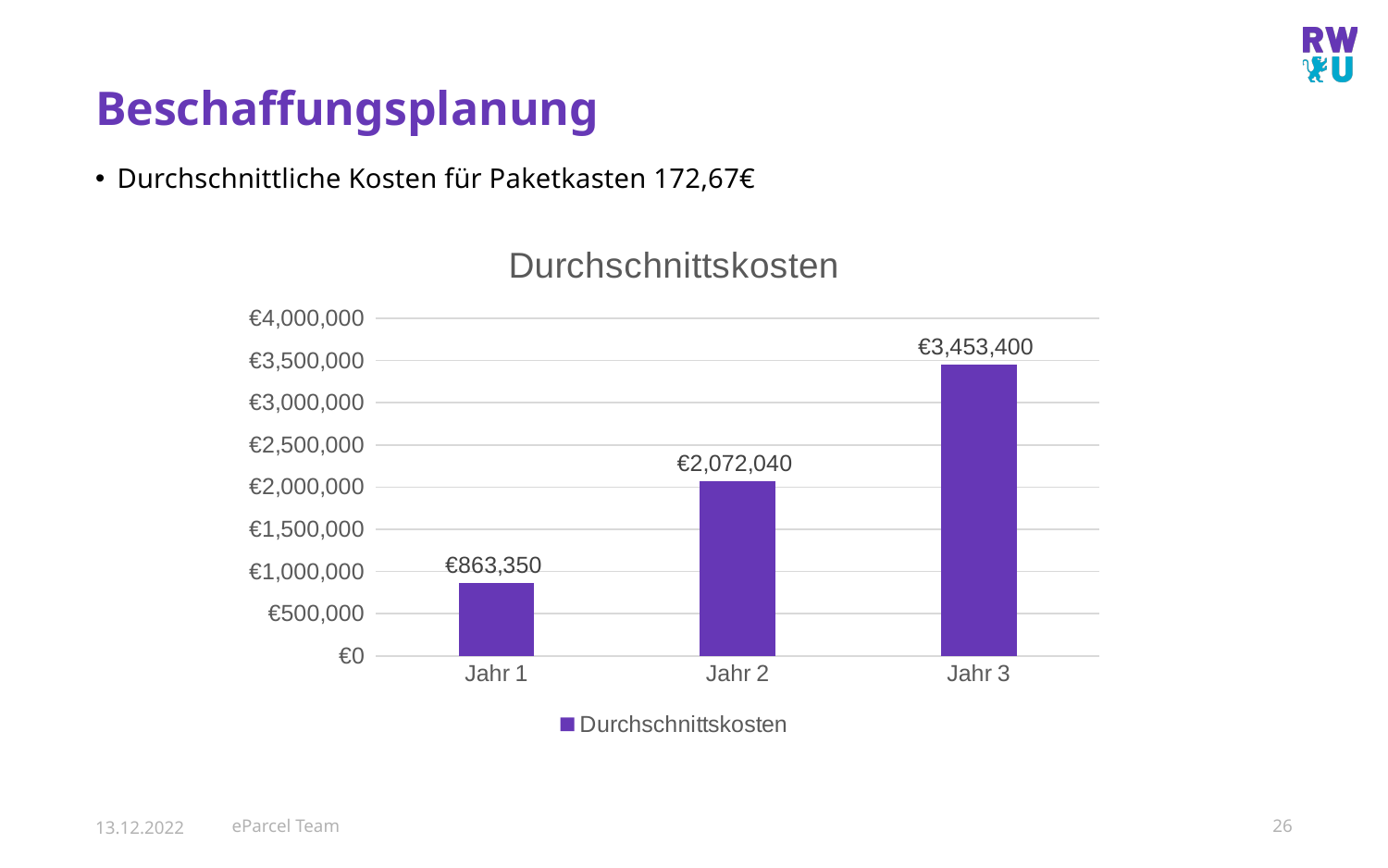
What is the difference between the values for Jahr 2 and Jahr 1? €1,208,690 What is the value for Jahr 2 in the Durchschnittskosten chart? €2,072,040 What is the value for Jahr 3 in the Durchschnittskosten chart? €3,453,400 How many categories are shown on the x axis of the chart? 3 Which year has the highest Durchschnittskosten? Jahr 3 Which is larger, the value for Jahr 1 or the value for Jahr 2? Jahr 2 Which year has the lowest Durchschnittskosten? Jahr 1 What is the value for Jahr 1 in the Durchschnittskosten chart? €863,350 Is the value for Jahr 3 greater or less than €3,000,000? greater Do the values rise or fall from Jahr 1 to Jahr 3? rise What kind of chart is shown on the slide? bar chart What is the difference between the values for Jahr 3 and Jahr 2? €1,381,360